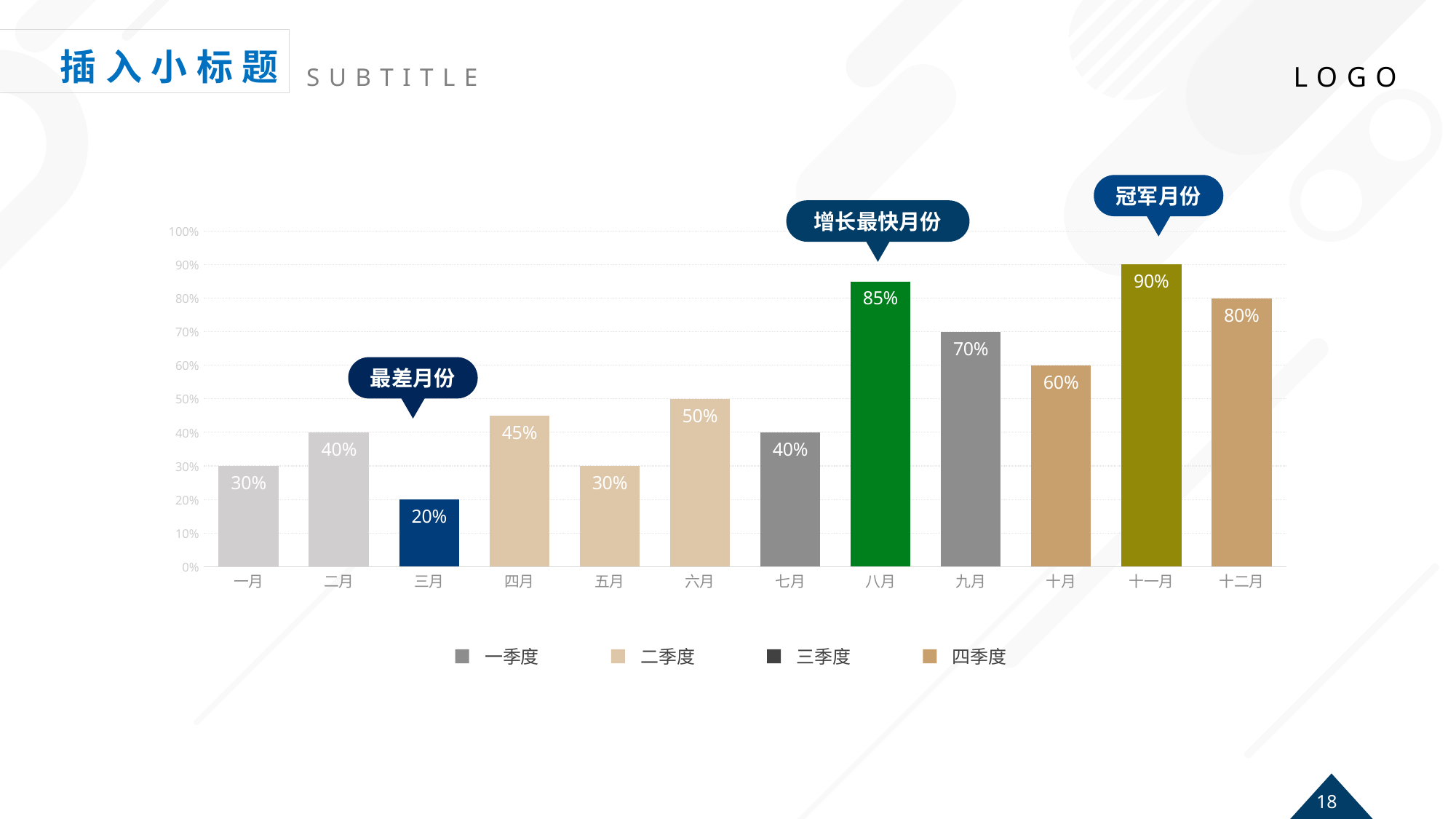
How many months are shown on the x axis? 12 Which month has the highest value? 十一月 How many series does the legend list? 4 What is the value for 八月? 85% Which month has the lowest value? 三月 Is the value for 四月 greater or less than 40%? greater Which month is labelled with the callout 增长最快月份? 八月 What is the value for 十二月? 80% Which is larger, the value for 九月 or the value for 六月? 九月 What is the value for 三月? 20% What kind of chart is shown on the slide? bar chart What is the difference between the values for 十一月 and 十月? 30%